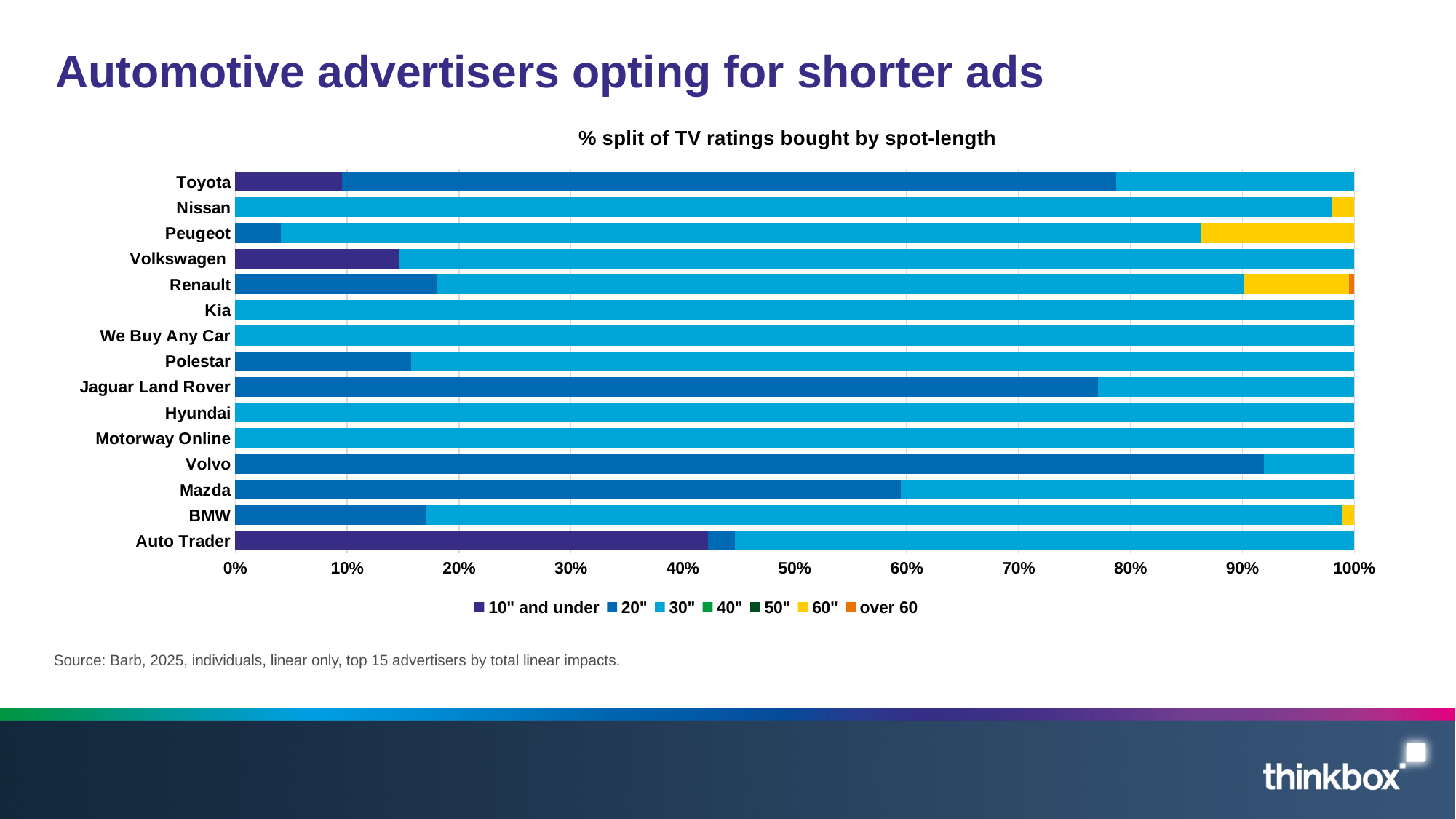
What kind of chart is shown on the slide? Stacked bar chart How many advertisers are listed on the chart? 15 Is the 10" and under share for Toyota greater or less than 20%? less How many series does the legend list? 7 Is the 20" share for Jaguar Land Rover greater or less than 70%? greater Is the 20" share for Volvo greater or less than 80%? greater Which advertiser has the largest share of ratings bought at 10" and under? Auto Trader Which advertiser has the largest share of ratings bought at 60"? Peugeot What is the title of the chart? % split of TV ratings bought by spot-length Which advertiser has the largest share of ratings bought at 20"? Volvo Which has the larger 10" and under share, Auto Trader or Volkswagen? Auto Trader